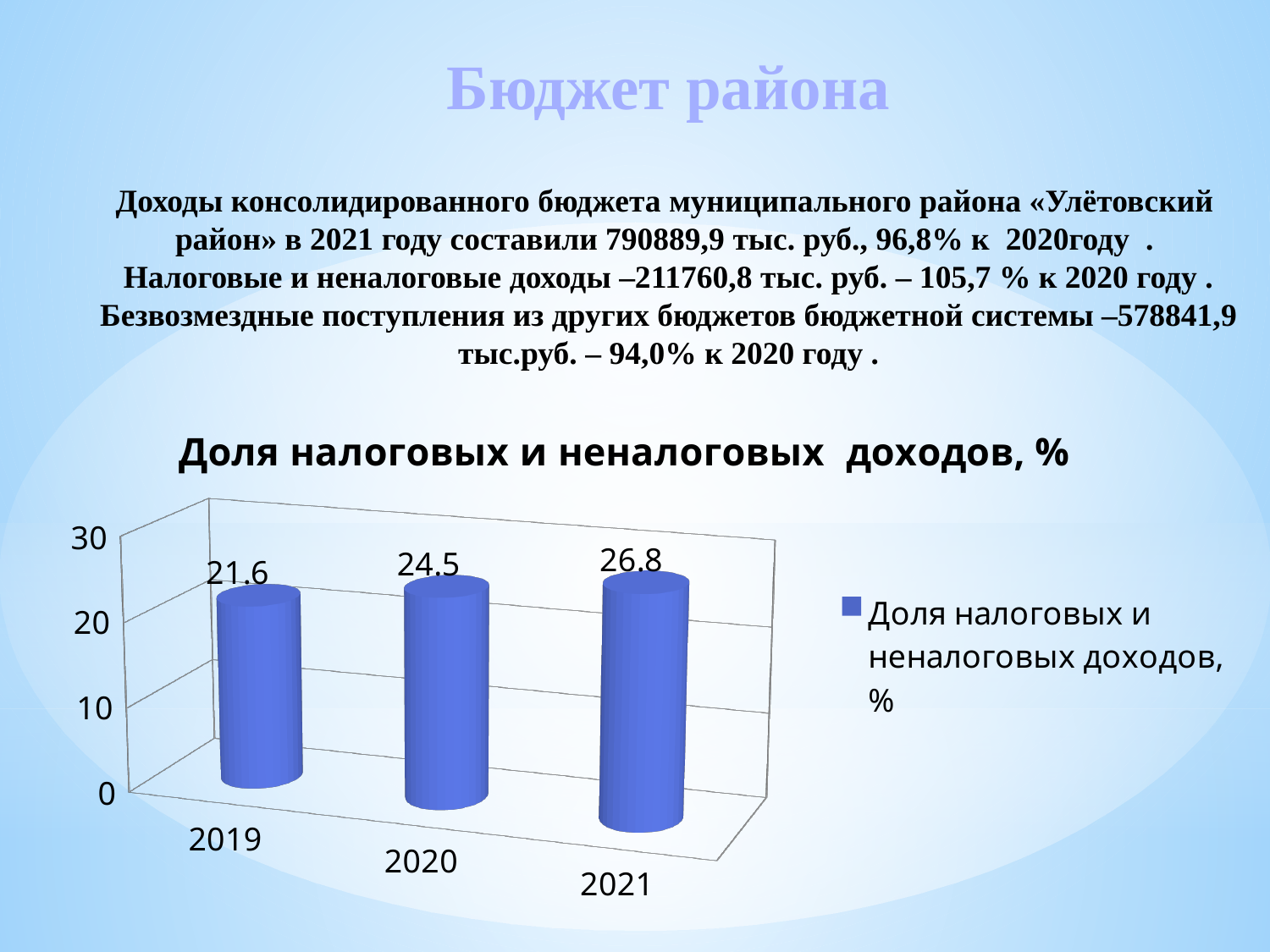
How many series does the legend list? 1 Which year has the highest share of tax and non-tax revenues? 2021 Which is larger, the value for 2020 or the value for 2021? 2021 What is the value for 2020? 24.5 What is the value for 2019? 21.6 What kind of chart is shown? bar chart How many years are shown on the x axis? 3 What is the value for 2021? 26.8 What is the difference between the values for 2021 and 2019? 5.2 Which year has the lowest share of tax and non-tax revenues? 2019 Do the values rise or fall from 2019 to 2021? rise What is the difference between the values for 2020 and 2019? 2.9